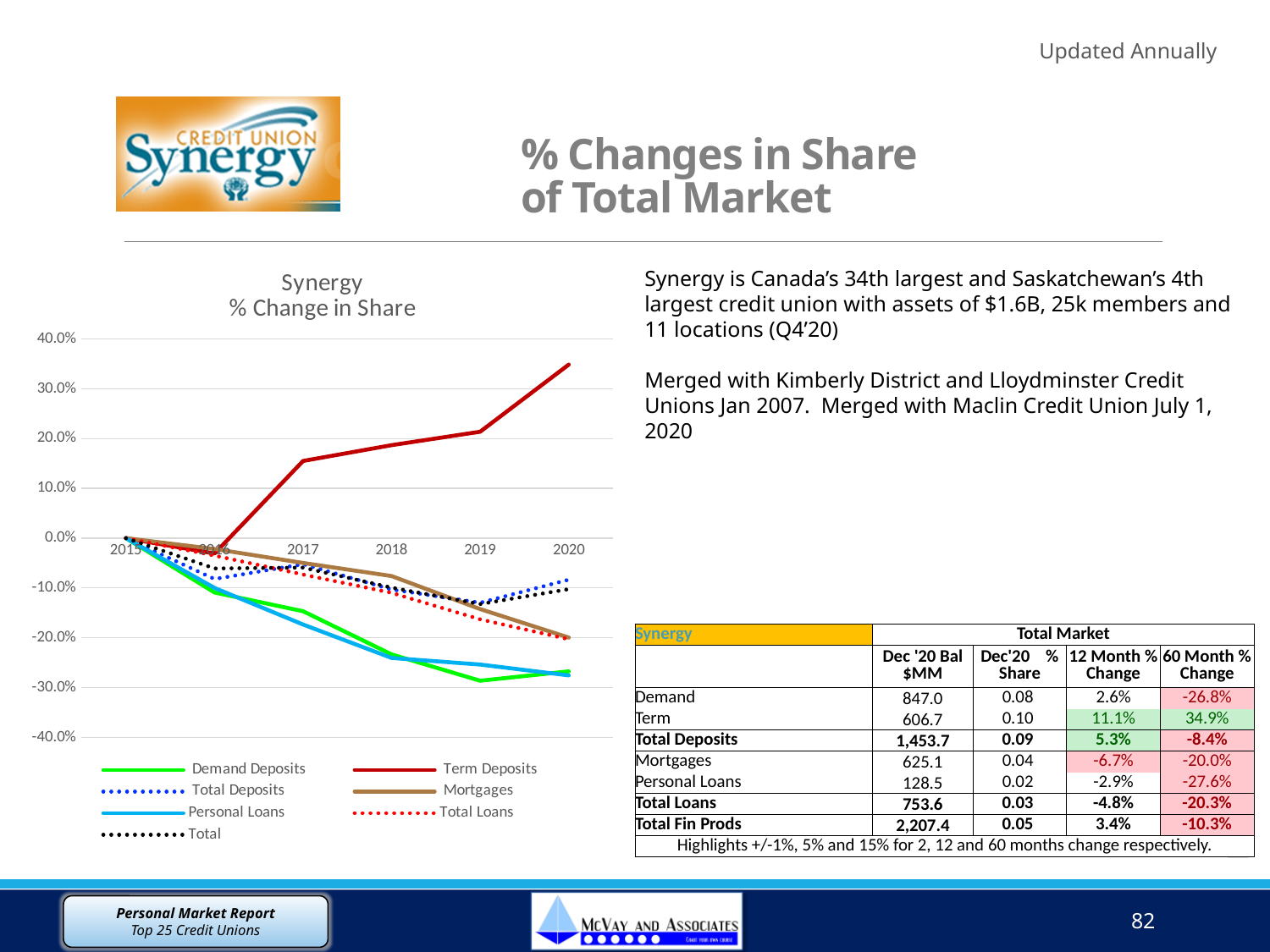
What is the title of the chart? Synergy % Change in Share Is the value for Term Deposits in 2020 greater or less than 30.0%? greater How many series does the chart legend list? 7 Is the value for Term Deposits in 2017 greater or less than 10.0%? greater Does the Term Deposits line rise or fall from 2015 to 2020? rise Does the Demand Deposits line rise or fall from 2015 to 2020? fall What kind of chart is shown on the slide? line chart Which series has the highest value in 2020? Term Deposits Is the value for Demand Deposits in 2019 greater or less than -20.0%? less Which series has the lowest value in 2019? Demand Deposits How many years are plotted along the x axis of the chart? 6 In 2020, which is larger: Term Deposits or Mortgages? Term Deposits